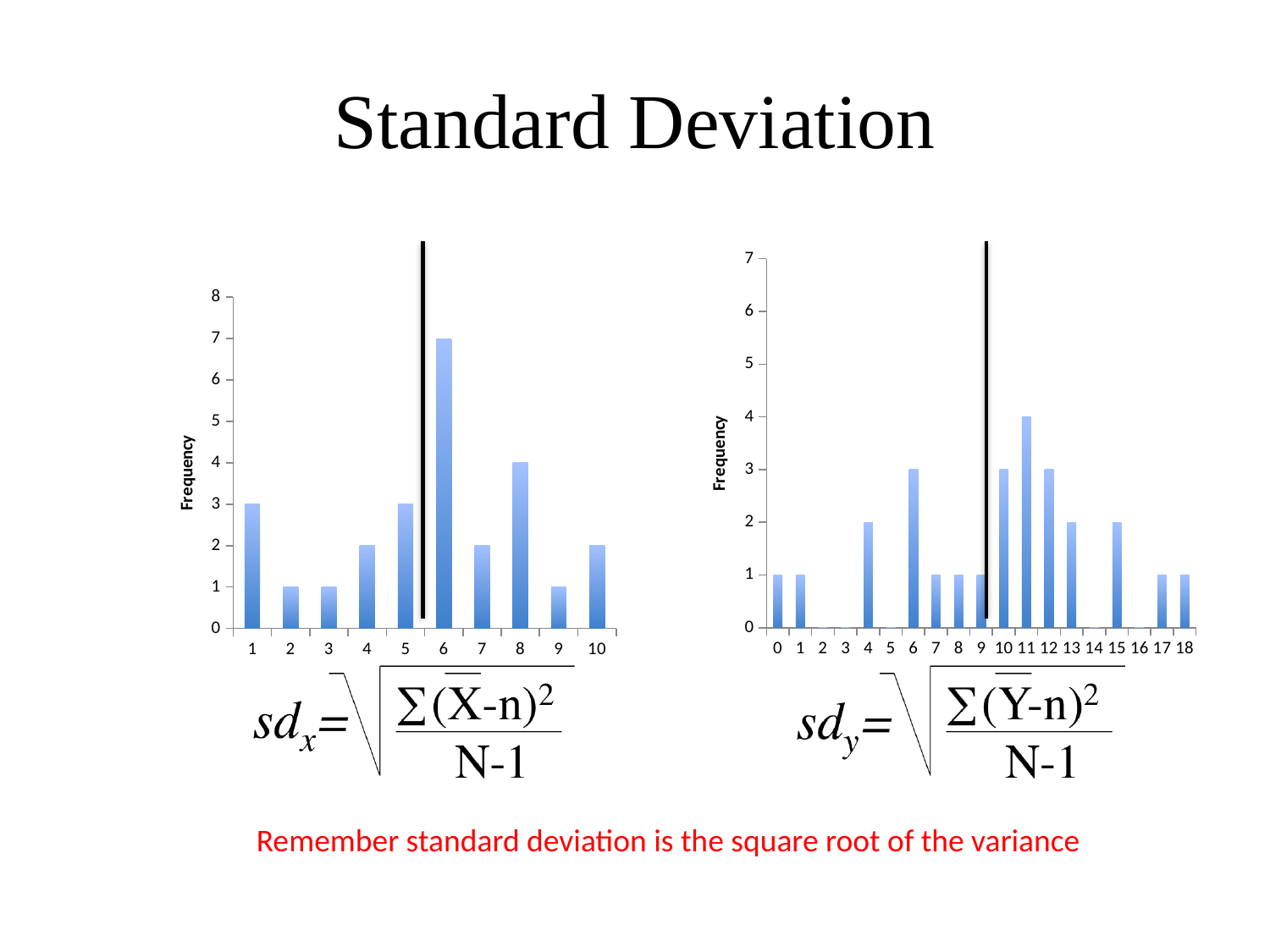
In the left chart, what is the frequency for category 6? 7 In the left chart, which is larger, the frequency for category 1 or the frequency for category 2? category 1 In the right chart, which category has the highest frequency? 11 In the right chart, which is larger, the frequency for category 4 or the frequency for category 7? category 4 In the right chart, what is the frequency for category 11? 4 What is the label on the vertical axis of the right chart? Frequency In the left chart, which category has the highest frequency? 6 What kind of chart is the left chart? bar chart In the right chart, what is the frequency for category 6? 3 In the left chart, what is the frequency for category 8? 4 In the left chart, what is the difference between the frequency for category 6 and the frequency for category 8? 3 How many categories are shown on the x axis of the left chart? 10